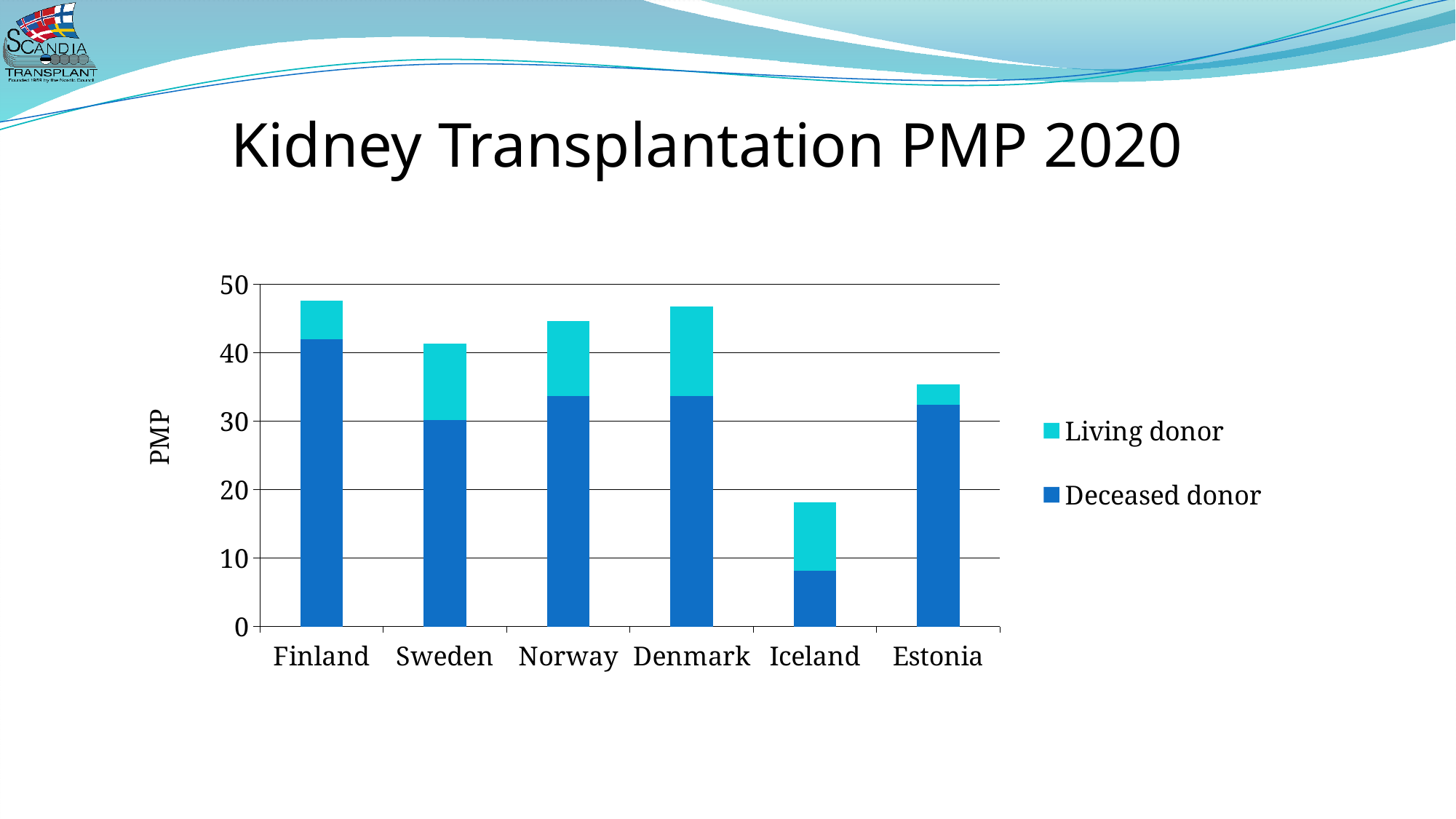
Which is larger, the living donor PMP for Iceland or for Estonia? Iceland How many countries are shown on the x axis of the chart? 6 What is the label on the chart's y axis? PMP How many series does the chart's legend list? 2 Which country has the highest deceased donor PMP? Finland Which country has the lowest total kidney transplantation PMP? Iceland Is the total value for Finland greater or less than 40? greater Is the deceased donor value for Iceland greater or less than 10? less Is the total value for Iceland greater or less than 20? less Which country has the lowest deceased donor PMP? Iceland Which is larger, the deceased donor PMP for Finland or for Sweden? Finland What kind of chart is shown on the slide? Stacked bar chart